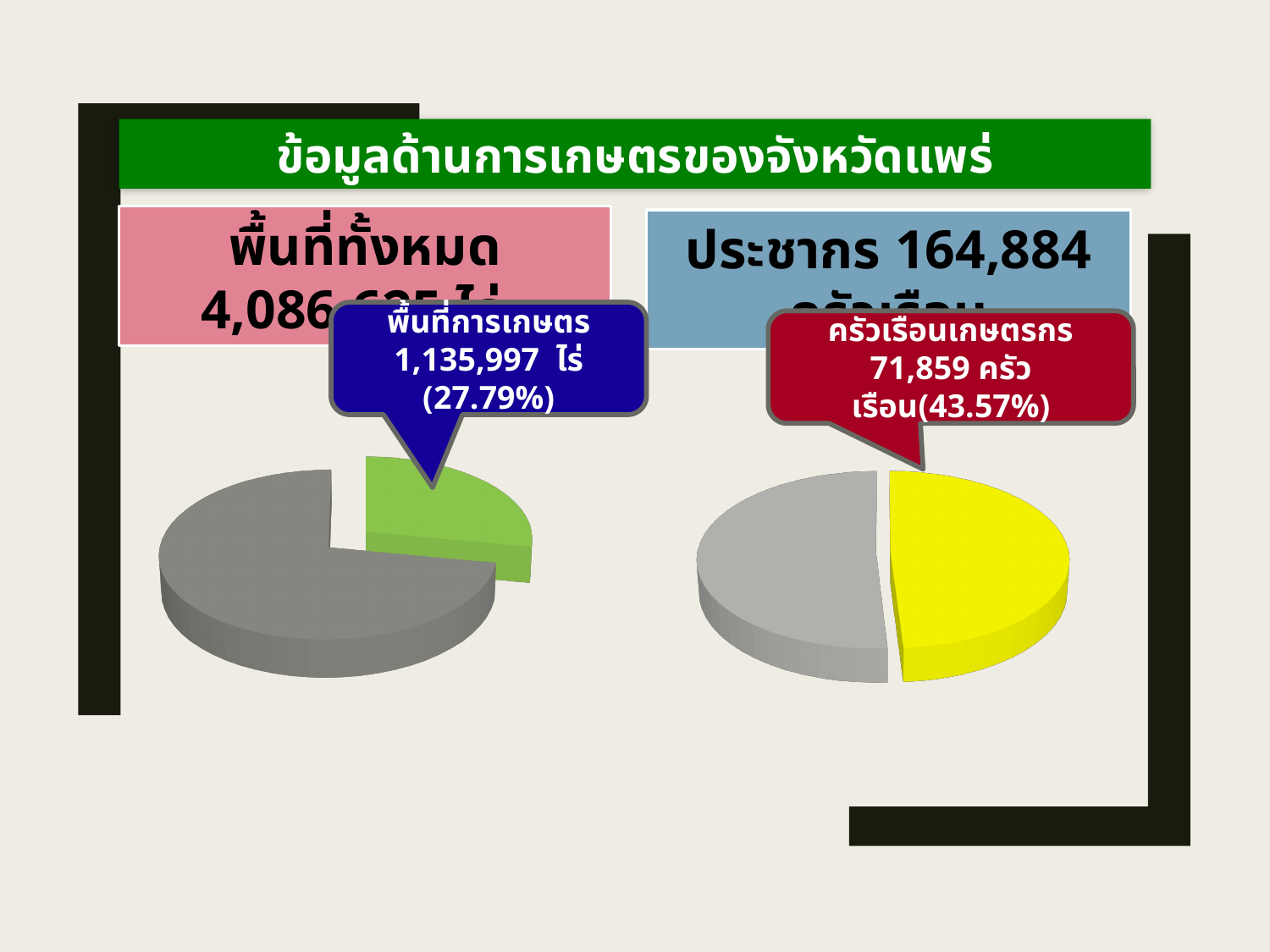
How many pie charts are on the slide? 2 In the right pie chart, how many farmer households (ครัวเรือนเกษตรกร) are shown in the callout? 71,859 ครัวเรือน In the left pie chart, what share of the total area is agricultural area (พื้นที่การเกษตร)? 27.79% In the right pie chart, is the yellow slice (farmer households) larger or smaller than the grey slice? Smaller In the left pie chart, what is the agricultural area (พื้นที่การเกษตร) shown in the callout? 1,135,997 ไร่ In the right pie chart, what share of households are farmer households (ครัวเรือนเกษตรกร)? 43.57% In the left pie chart, is the green slice (agricultural area) larger or smaller than the grey slice? Smaller What is the title of the slide? ข้อมูลด้านการเกษตรของจังหวัดแพร่ What colour is the agricultural area slice in the left pie chart? Green Which chart shows a larger share for its highlighted slice, the left pie chart (27.79%) or the right pie chart (43.57%)? The right pie chart What type of charts are shown on the slide? Pie charts What is the total number of households (ประชากร) shown above the right pie chart? 164,884 ครัวเรือน